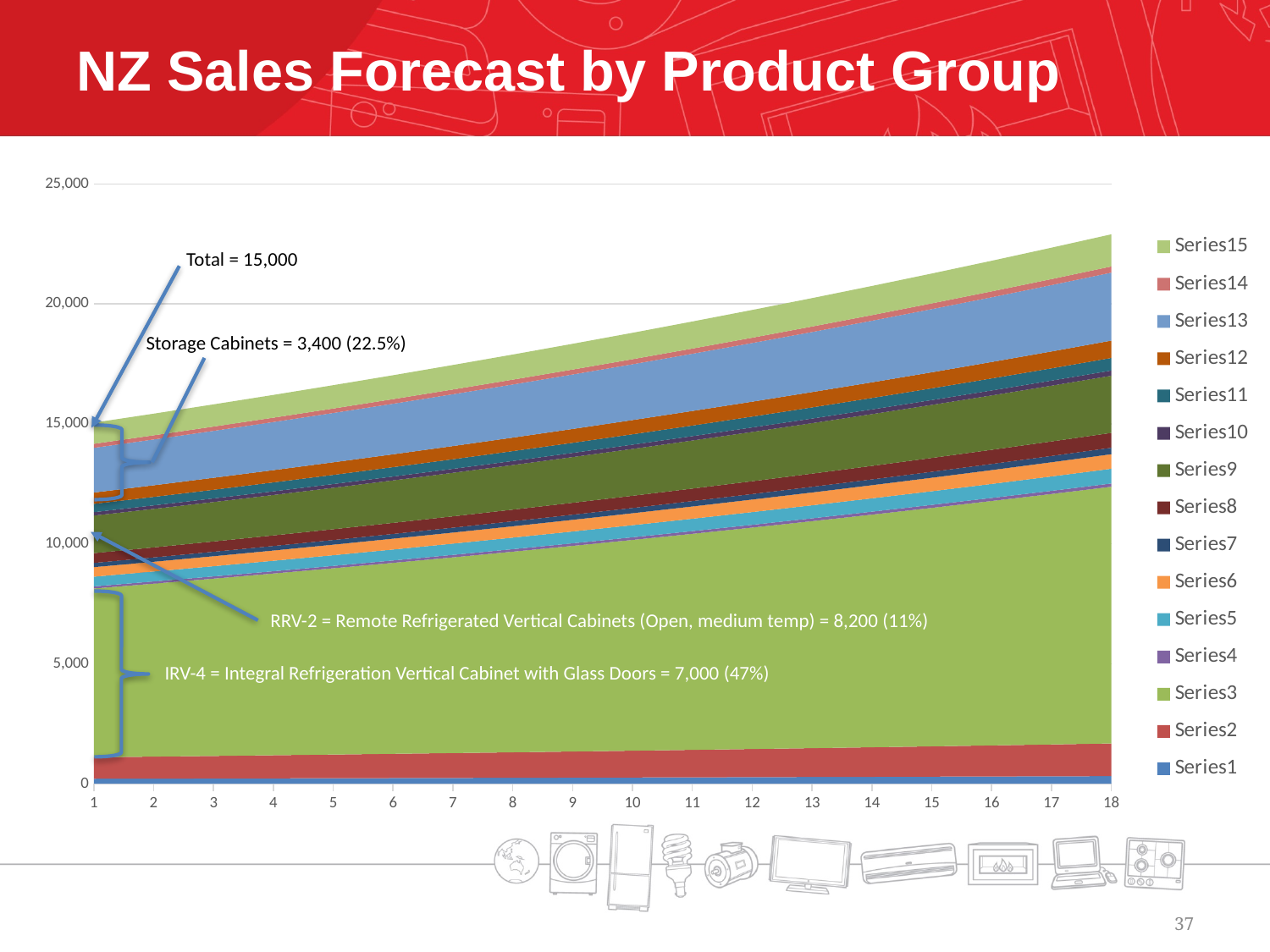
Is the total stacked value at point 18 greater or less than 20,000? greater What value does the annotation give for IRV-4 (Integral Refrigeration Vertical Cabinet with Glass Doors)? 7,000 (47%) Does the total stacked value rise or fall from point 1 to point 18? Rise What is the title of the slide? NZ Sales Forecast by Product Group What value does the annotation give for RRV-2 (Remote Refrigerated Vertical Cabinets)? 8,200 (11%) According to the annotation, what is the total at point 1? 15,000 What is the highest value shown on the y axis? 25,000 What kind of chart is shown on the slide? Stacked area chart Which series occupies the largest area in the chart? Series3 How many series does the legend list? 15 What value does the annotation give for Storage Cabinets? 3,400 (22.5%) How many points are there along the x axis? 18